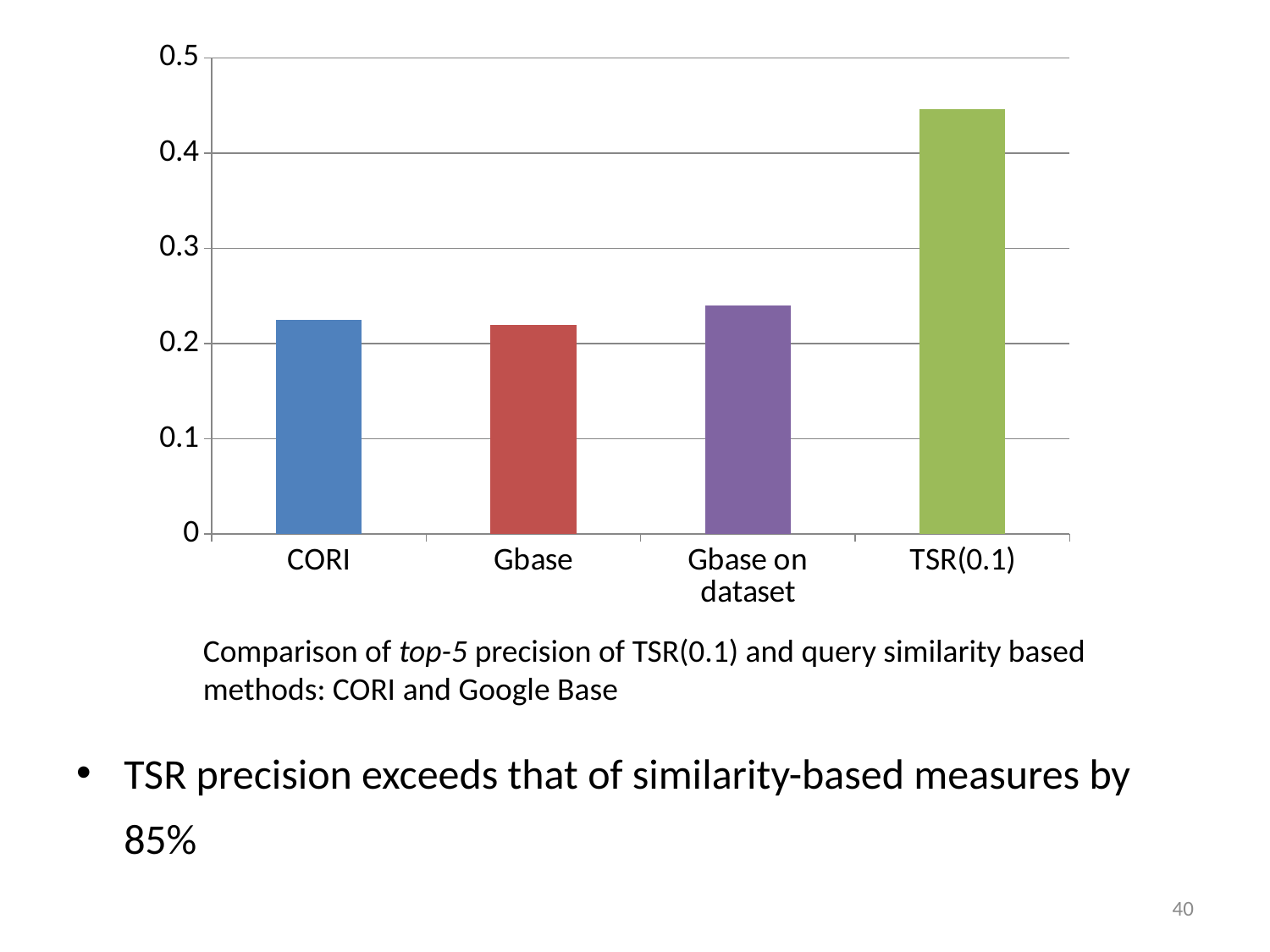
What colour is the bar for TSR(0.1)? green What is the label of the third category on the x axis of the chart? Gbase on dataset Is the value for CORI greater or less than 0.3? less Which is larger, the value for Gbase or the value for TSR(0.1)? TSR(0.1) How many categories are plotted on the x axis of the chart? 4 Is the value for Gbase on dataset greater or less than 0.3? less What kind of chart is shown on the slide? bar chart Is the value for Gbase greater or less than 0.2? greater Which category has the highest bar in the chart? TSR(0.1) Which is larger, the value for TSR(0.1) or the value for CORI? TSR(0.1)